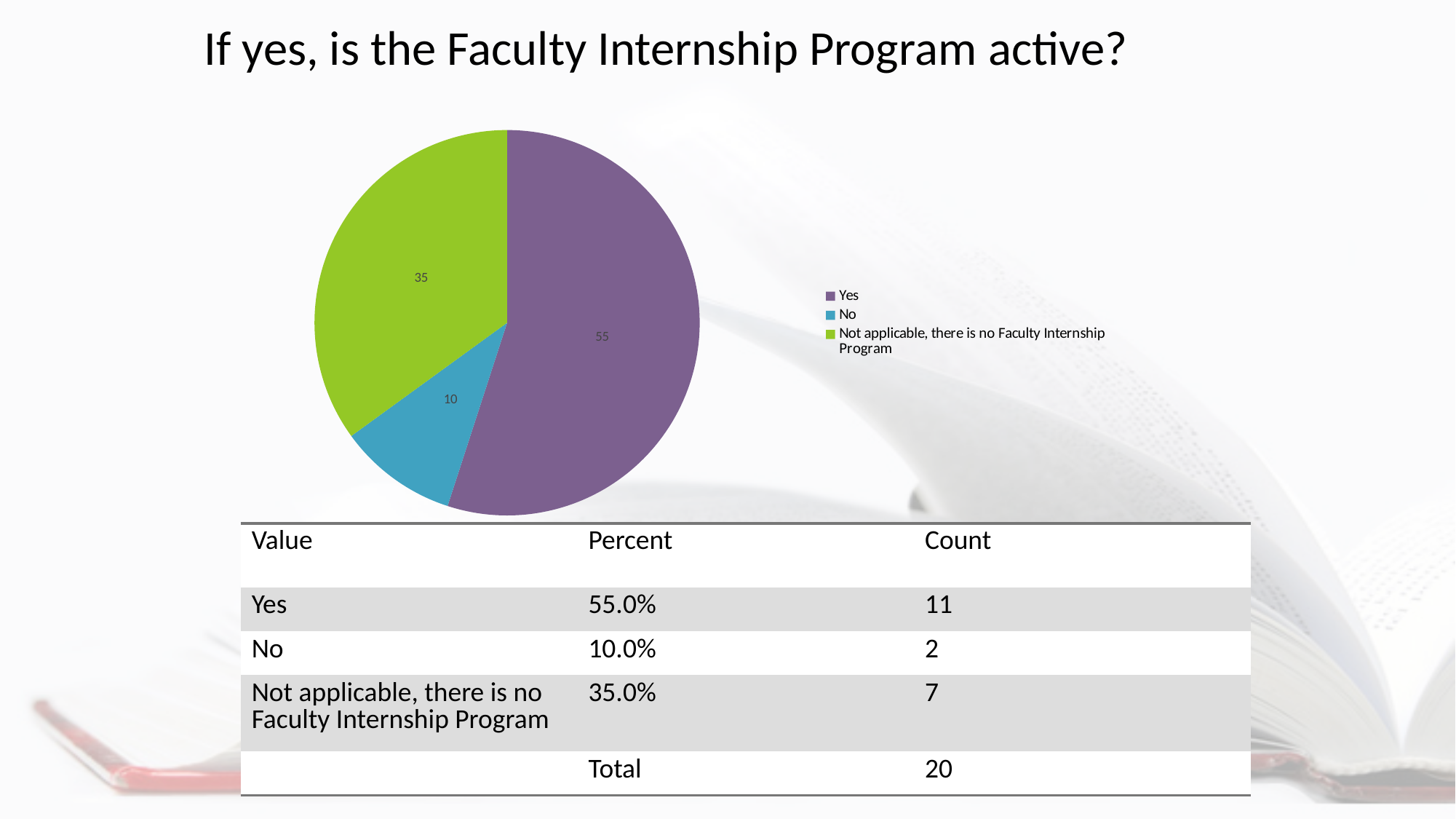
What value is labelled on the 'Not applicable, there is no Faculty Internship Program' slice of the pie chart? 35 What is the difference between the Yes slice value and the No slice value in the pie chart? 45 Which category has the largest slice in the pie chart? Yes Which slice is larger in the pie chart: Yes or 'Not applicable, there is no Faculty Internship Program'? Yes What colour is the Yes slice in the pie chart? purple How many slices does the pie chart have? 3 What value is labelled on the Yes slice of the pie chart? 55 What value is labelled on the No slice of the pie chart? 10 How many entries does the legend of the pie chart list? 3 What type of chart is shown on the slide? pie chart Which category has the smallest slice in the pie chart? No What is the title of the slide containing the pie chart? If yes, is the Faculty Internship Program active?